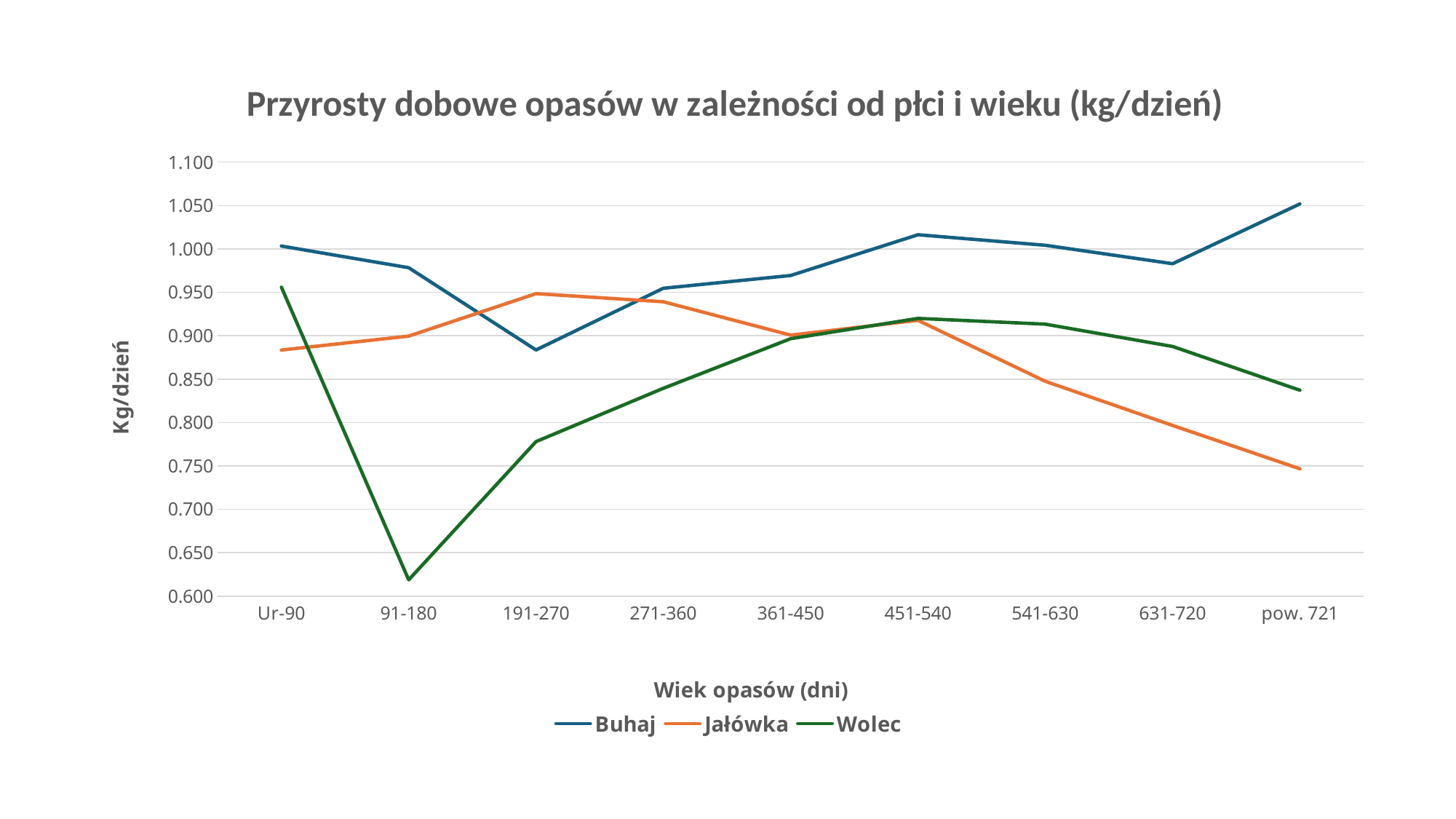
How many age categories are shown on the x axis? 9 Is the value for Buhaj at 191-270 greater or less than 0.900? less In which age category does the Buhaj series reach its highest value? pow. 721 At Ur-90, which series has the higher value, Buhaj or Jałówka? Buhaj At pow. 721, which series has the higher value, Wolec or Jałówka? Wolec Is the value for Wolec at 91-180 greater or less than 0.650? less Is the value for Buhaj at pow. 721 greater or less than 1.000? greater In which age category does the Wolec series reach its lowest value? 91-180 What kind of chart is shown on the slide? line chart How many series does the legend list? 3 In which age category does the Jałówka series reach its lowest value? pow. 721 Does the Jałówka series rise or fall from 451-540 to pow. 721? fall